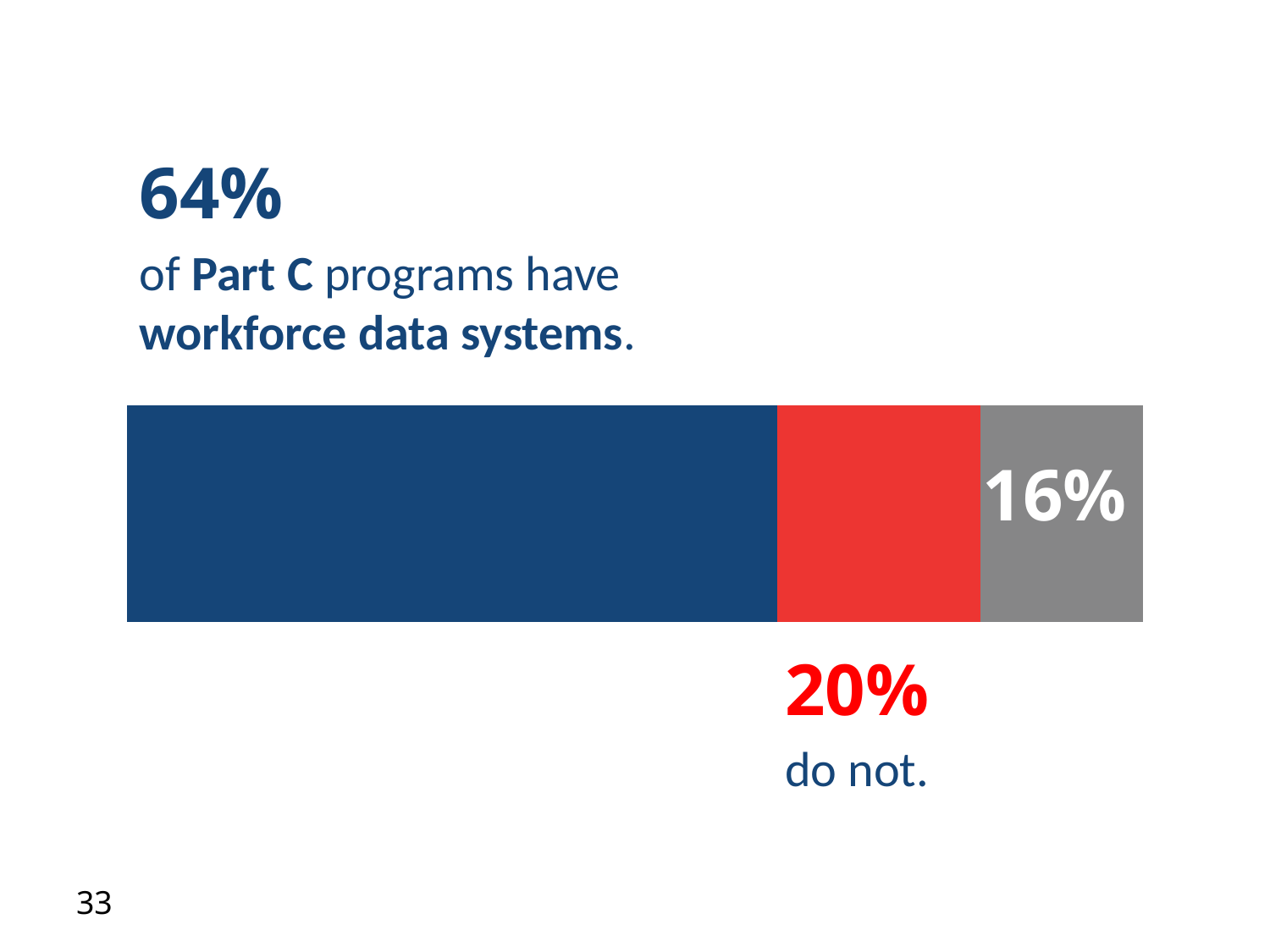
Which segment of the bar is the largest? The blue segment (64%, have workforce data systems) What percentage of Part C programs do not have workforce data systems? 20% How many segments make up the bar? 3 What do the three segments of the bar add up to? 100% Which is larger, the red segment or the grey segment? The red segment (20%) What is the difference between the share of Part C programs that have workforce data systems and the share that do not? 44 percentage points What colour is the segment representing Part C programs that have workforce data systems? Blue Which segment of the bar is the smallest? The grey segment (16%) What value is printed on the grey segment of the bar? 16% What is the difference between the red segment (20%) and the grey segment (16%)? 4 percentage points What kind of chart is shown on the slide? A stacked bar chart What percentage of Part C programs have workforce data systems, according to the chart? 64%